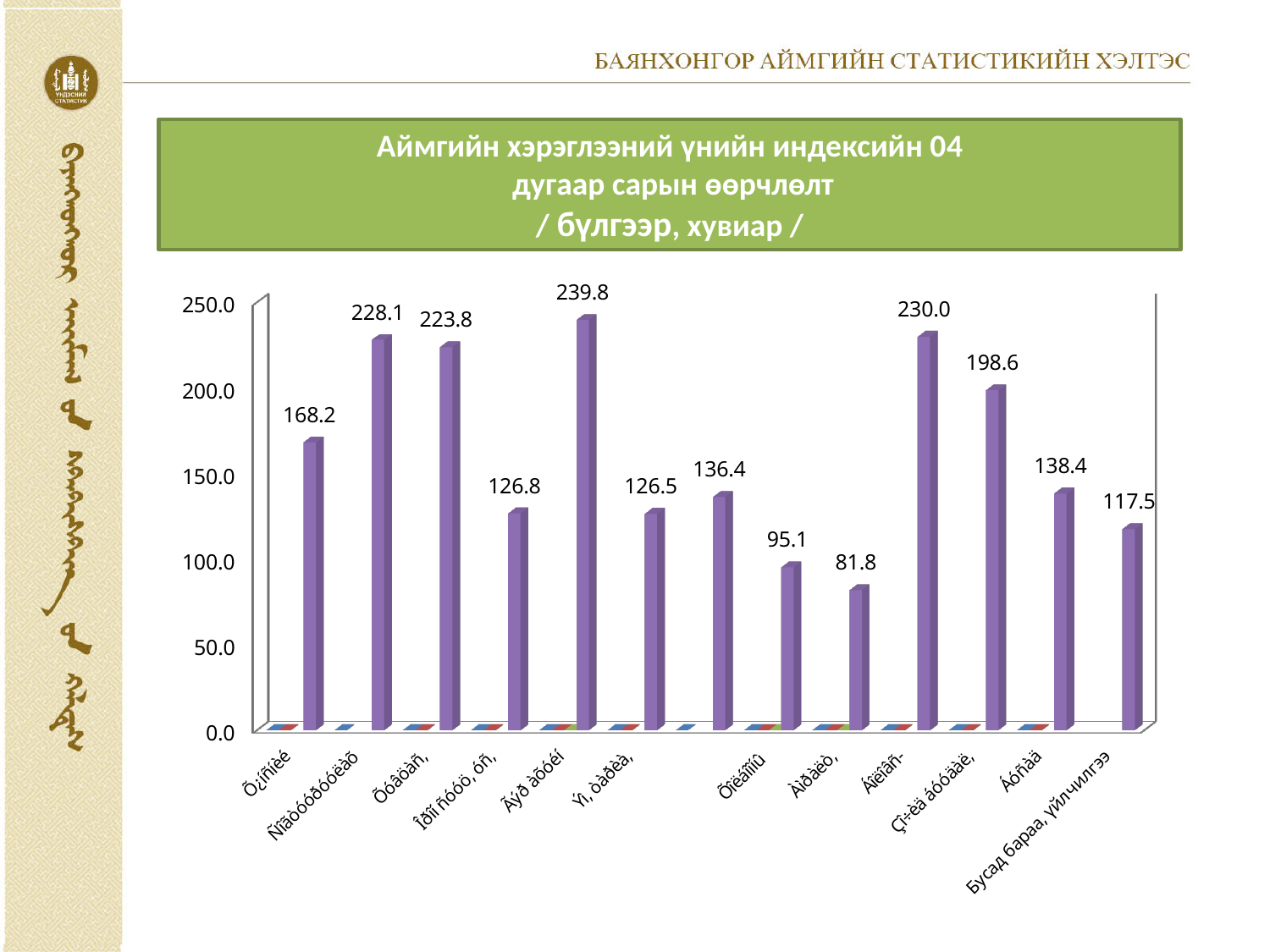
Which is larger: the value of the first (leftmost) bar or the value for "Бусад бараа, үйлчилгээ"? the first bar (168.2) What is the value shown for the category "Бусад бараа, үйлчилгээ"? 117.5 What is the lowest value labelled on any bar in the chart? 81.8 What is the difference between the highest bar value (239.8) and the lowest bar value (81.8)? 158.0 How many bars are plotted in the chart? 13 What is the highest value labelled on any bar in the chart? 239.8 What kind of chart is shown on the slide? bar chart Is the value for "Бусад бараа, үйлчилгээ" greater or less than 100? greater What value is labelled on the first (leftmost) bar of the chart? 168.2 What is the difference between the bar labelled 230.0 and the bar labelled 198.6? 31.4 What is the title of the chart on the slide? Аймгийн хэрэглээний үнийн индексийн 04 дугаар сарын өөрчлөлт / бүлгээр, хувиар / How many bars in the chart have values above 200? 4